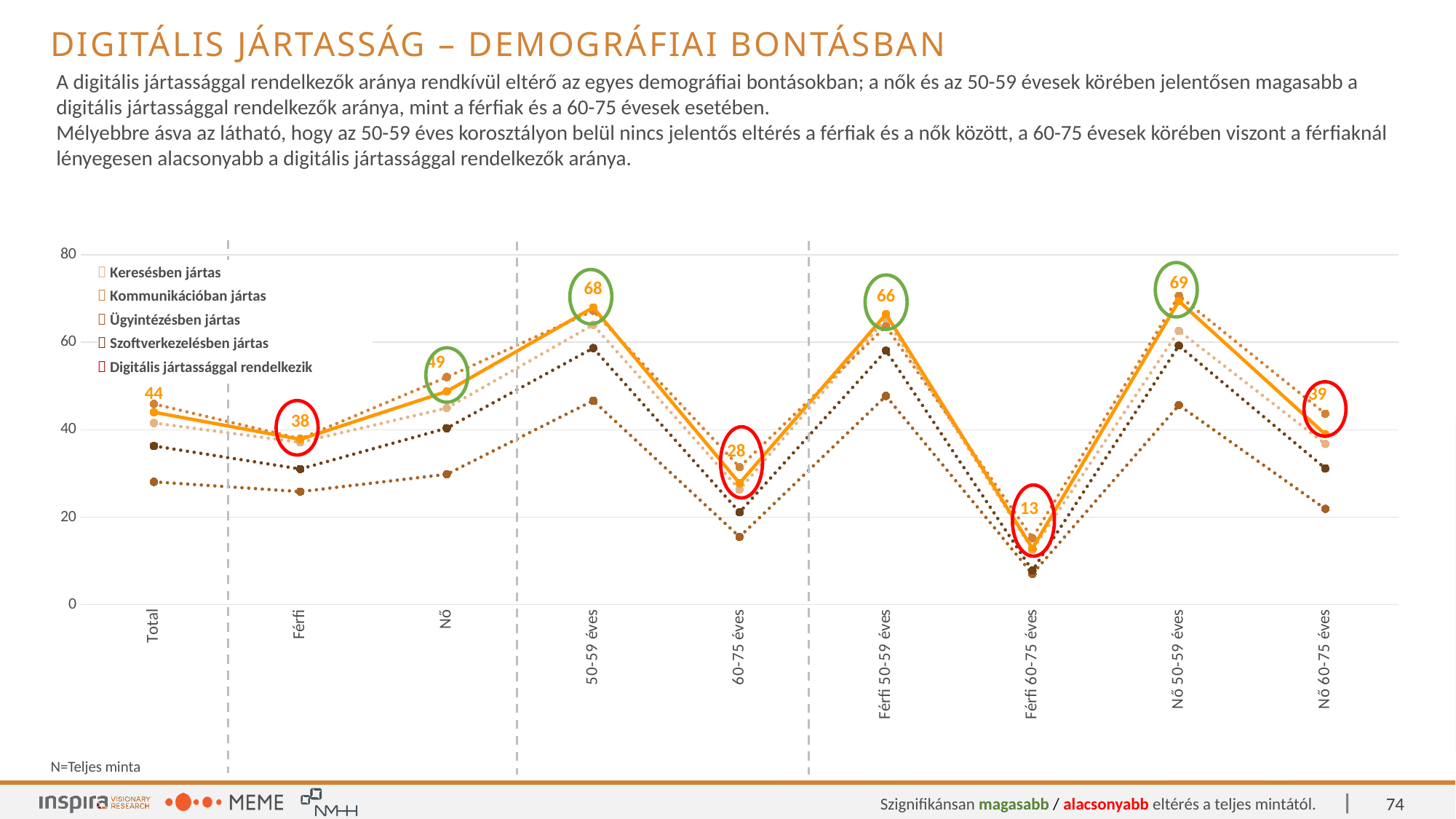
What is the value for Nő 50-59 éves on the Digitális jártassággal rendelkezik line? 69 What is the value for Total on the Digitális jártassággal rendelkezik line? 44 What is the value for Férfi 60-75 éves on the Digitális jártassággal rendelkezik line? 13 What is the difference between the 50-59 éves and 60-75 éves values on the Digitális jártassággal rendelkezik line? 40 What is the difference between the Nő and Férfi values on the Digitális jártassággal rendelkezik line? 11 On the Digitális jártassággal rendelkezik line, which is larger: Férfi 50-59 éves or Nő 50-59 éves? Nő 50-59 éves What kind of chart is shown on the slide? line chart Which category has the lowest labelled value on the Digitális jártassággal rendelkezik line? Férfi 60-75 éves How many categories are shown on the x axis of the chart? 9 How many series does the chart legend list? 5 Does the Digitális jártassággal rendelkezik line rise or fall from Férfi 60-75 éves to Nő 50-59 éves? rise Which category has the highest labelled value on the Digitális jártassággal rendelkezik line? Nő 50-59 éves